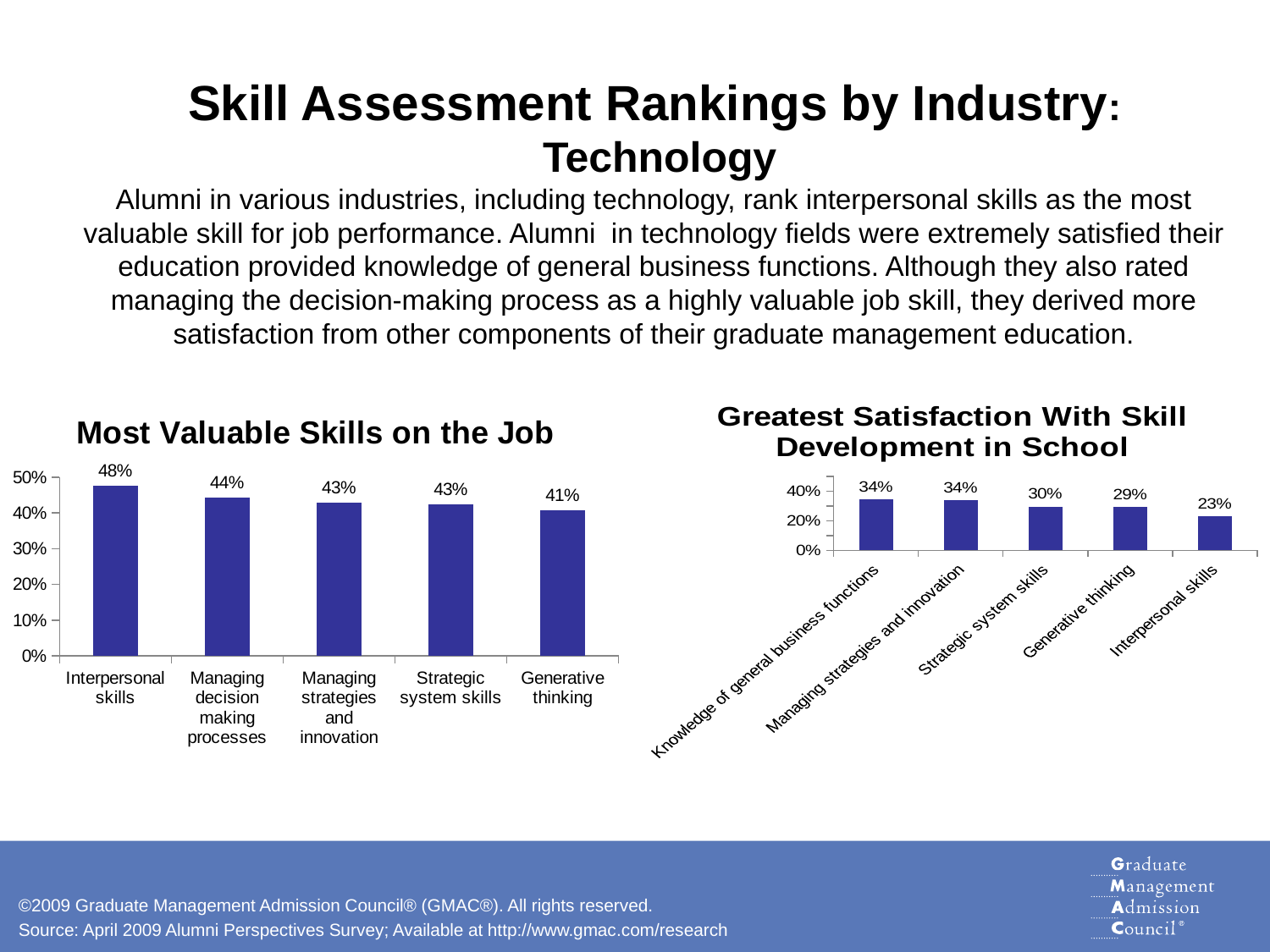
In the 'Most Valuable Skills on the Job' chart, what is the difference between Interpersonal skills and Managing decision making processes? 4% What kind of chart is 'Most Valuable Skills on the Job'? Bar chart In the 'Greatest Satisfaction With Skill Development in School' chart, what is the value for Strategic system skills? 30% In the 'Greatest Satisfaction With Skill Development in School' chart, do the values rise or fall from left to right? Fall In the 'Greatest Satisfaction With Skill Development in School' chart, what is the value for Interpersonal skills? 23% In the 'Greatest Satisfaction With Skill Development in School' chart, which skill has the lowest value? Interpersonal skills In the 'Greatest Satisfaction With Skill Development in School' chart, what is the difference between Knowledge of general business functions and Interpersonal skills? 11% In the 'Most Valuable Skills on the Job' chart, which skill has the highest value? Interpersonal skills In the 'Most Valuable Skills on the Job' chart, what is the value for Interpersonal skills? 48% In the 'Greatest Satisfaction With Skill Development in School' chart, which is larger: Strategic system skills or Interpersonal skills? Strategic system skills In the 'Most Valuable Skills on the Job' chart, how many skills are shown? 5 In the 'Most Valuable Skills on the Job' chart, what is the value for Generative thinking? 41%